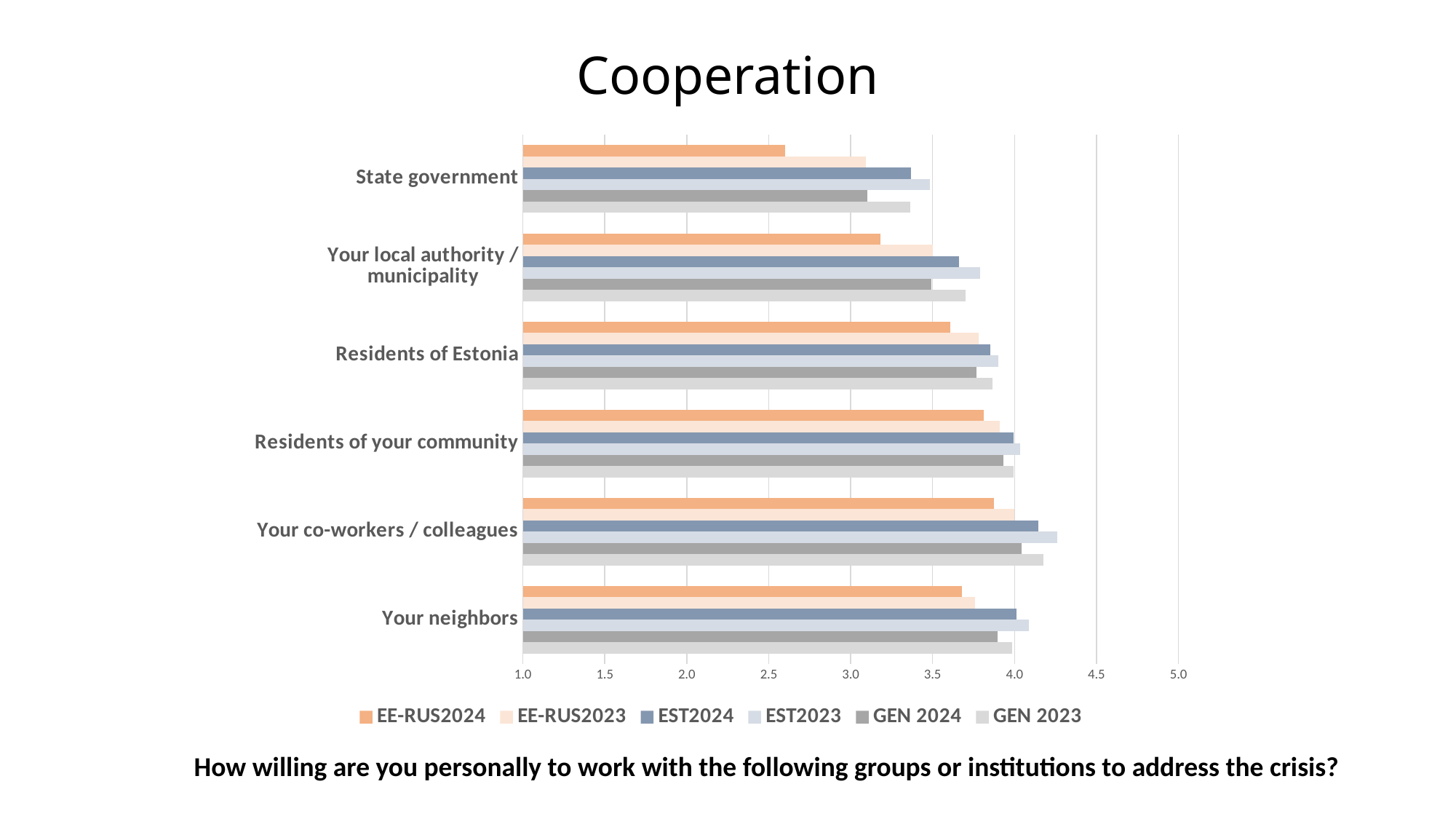
Is the EE-RUS2024 value for Your local authority / municipality greater or less than 3.5? less How many series does the legend list? 6 What kind of chart is shown on the slide? bar chart What is the title of the chart? Cooperation For the EST2023 series, which category has the highest value? Your co-workers / colleagues For the EE-RUS2024 series, which category has the lowest value? State government For Your neighbors, which is larger: the EE-RUS2024 value or the EST2024 value? EST2024 How many groups or institutions (categories) are listed on the chart? 6 Is the EE-RUS2024 value for State government greater or less than 3.0? less Is the GEN 2024 value for State government greater or less than 3.5? less For State government, which is larger: the EE-RUS2024 value or the EST2024 value? EST2024